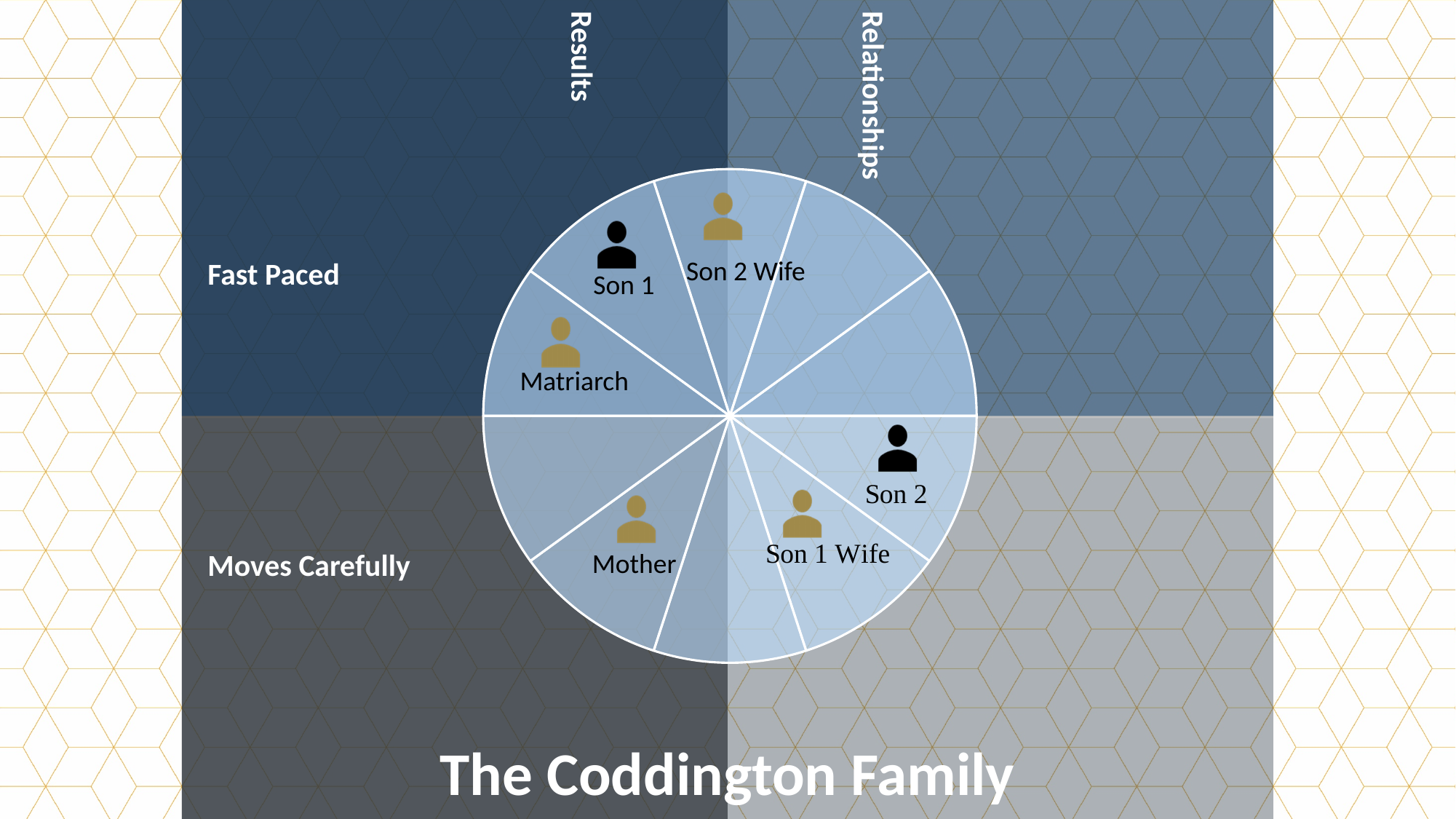
Which family member is placed in the Results / Moves Carefully quadrant? Mother Which two labels appear along the top of the chart, left and right of the vertical divider? Results and Relationships Which family member is placed in the Results / Fast Paced quadrant furthest to the left? Matriarch How many family members are labelled on the chart? 6 How many slices does the circular chart have? 10 What is the title shown at the bottom of the slide? The Coddington Family Which family member is placed in the Relationships / Moves Carefully quadrant nearest the right edge of the circle? Son 2 What kind of chart is shown on the slide? Pie chart